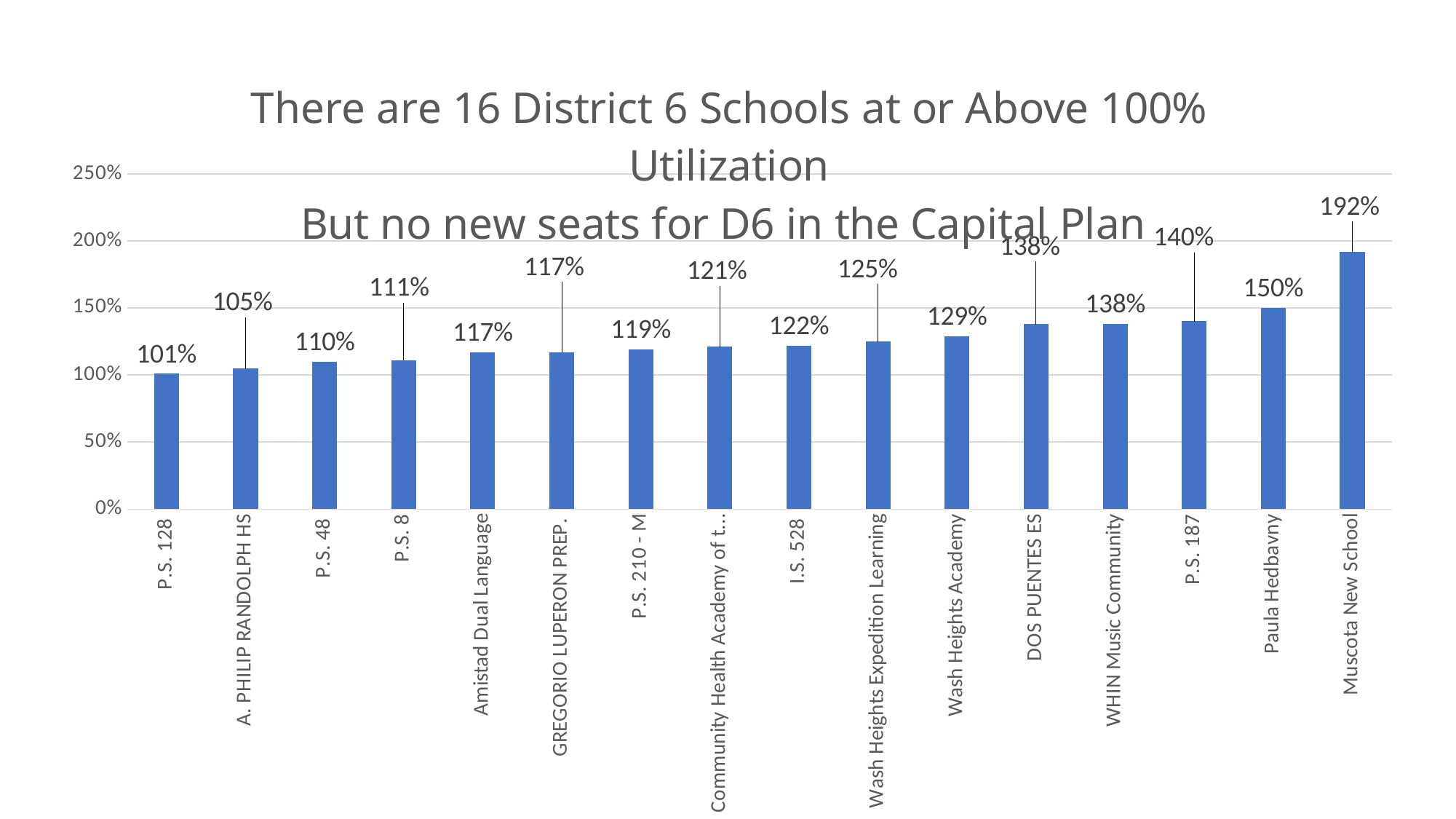
Which school has the lowest utilization? P.S. 128 What is the utilization value for P.S. 128? 101% What is the difference in utilization between Muscota New School and P.S. 128? 91% What kind of chart is shown on the slide? Bar chart How many schools are shown in the chart? 16 What is the utilization value for Paula Hedbavny? 150% What is the utilization value for Muscota New School? 192% What is the utilization value for Wash Heights Academy? 129% Which school has the highest utilization? Muscota New School What is the difference in utilization between Paula Hedbavny and P.S. 187? 10% Which has a higher utilization, P.S. 187 or I.S. 528? P.S. 187 Do the utilization values rise or fall from left to right along the x axis? Rise